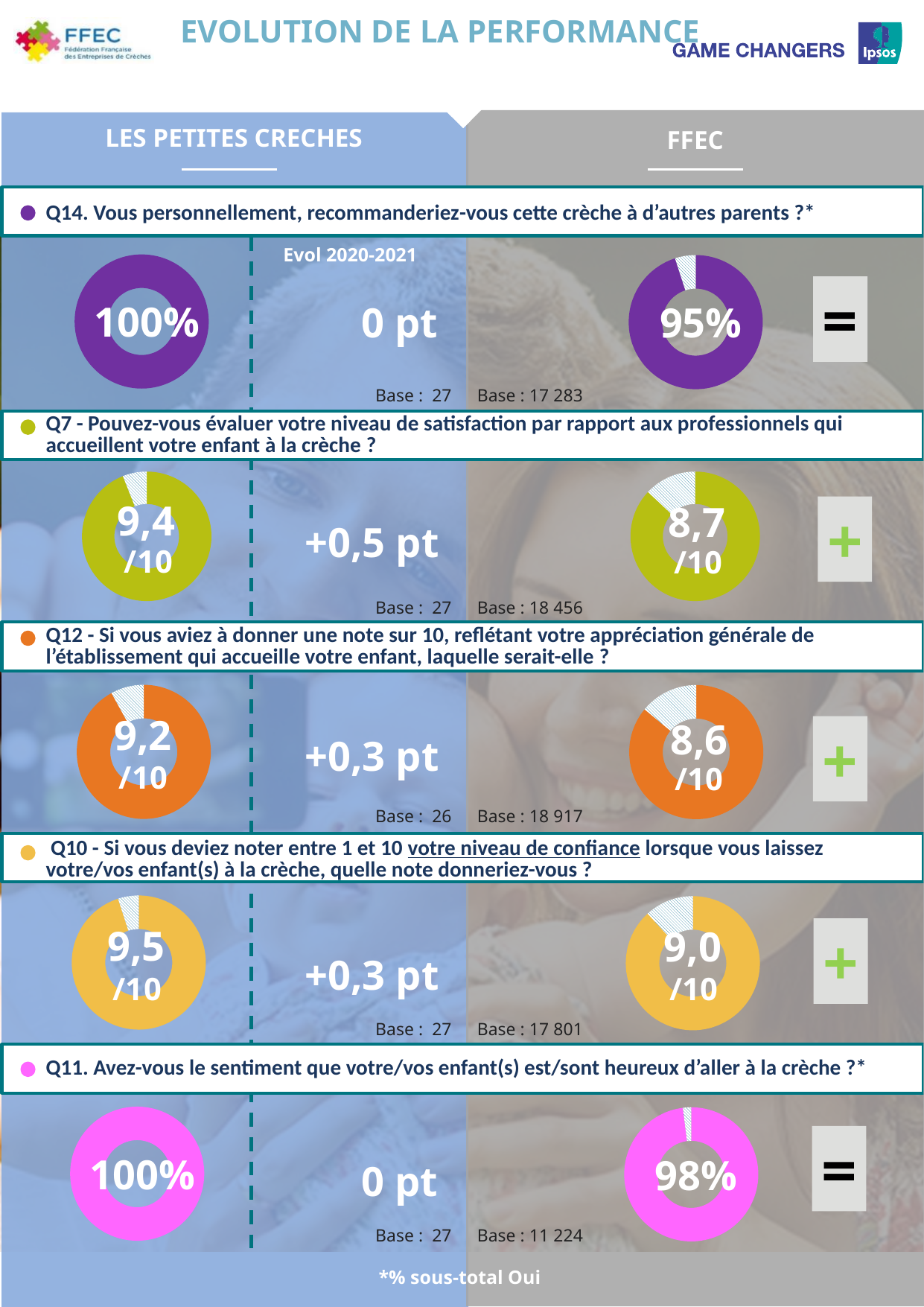
In the Q7 row, what score does the FFEC donut chart show? 8,7/10 In the Q14 row, what value does the Les Petites Creches donut chart show? 100% What is the 2020-2021 evolution shown for the Q7 row? +0,5 pt In the Q11 row, what value does the FFEC donut chart show? 98% In the Q12 row, what score does the FFEC donut chart show? 8,6/10 In the Q10 row, what score does the Les Petites Creches donut chart show? 9,5/10 In the Q14 row, what value does the FFEC donut chart show? 95% In the Q12 row, which donut chart shows the higher score, Les Petites Creches or FFEC? Les Petites Creches What kind of chart is used to display the values on this slide? Donut (pie) chart In the Q7 row, what score does the Les Petites Creches donut chart show? 9,4/10 In the Q10 row, what is the difference between the Les Petites Creches score and the FFEC score? 0,5 How many donut charts are shown on the slide in total? 10